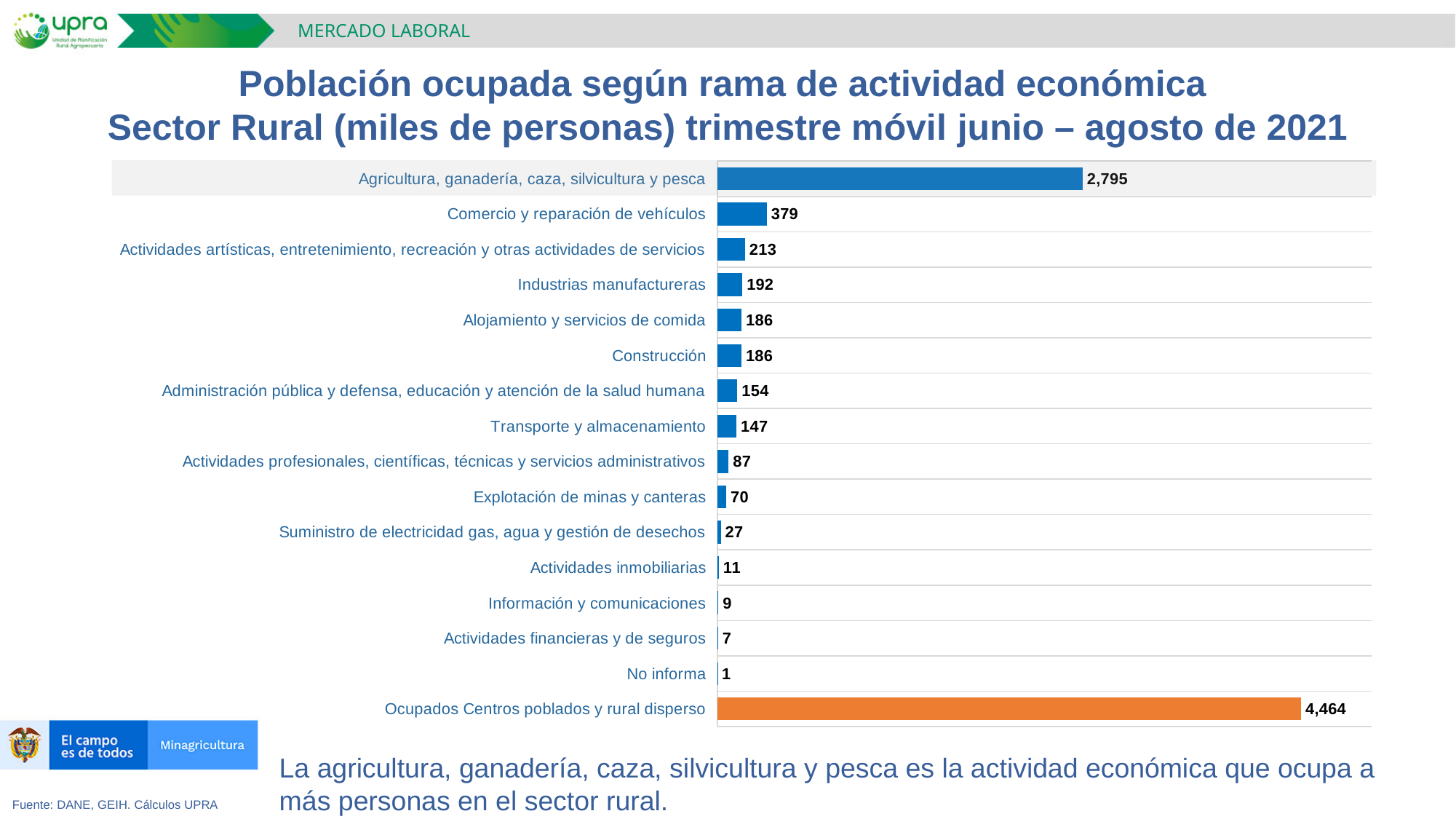
What kind of chart is shown on the slide? Bar chart Which category has the lowest value? No informa What is the value for Comercio y reparación de vehículos? 379 What is the value for Explotación de minas y canteras? 70 What is the value for the orange bar, Ocupados Centros poblados y rural disperso? 4,464 What is the value for Agricultura, ganadería, caza, silvicultura y pesca? 2,795 What is the difference between Ocupados Centros poblados y rural disperso and Agricultura, ganadería, caza, silvicultura y pesca? 1,669 Which economic activity (blue bar) has the highest value? Agricultura, ganadería, caza, silvicultura y pesca Which is larger, Transporte y almacenamiento or Administración pública y defensa, educación y atención de la salud humana? Administración pública y defensa, educación y atención de la salud humana Which bar is shown in orange rather than blue? Ocupados Centros poblados y rural disperso How many bars are plotted in the chart? 16 What is the difference between Comercio y reparación de vehículos and Industrias manufactureras? 187